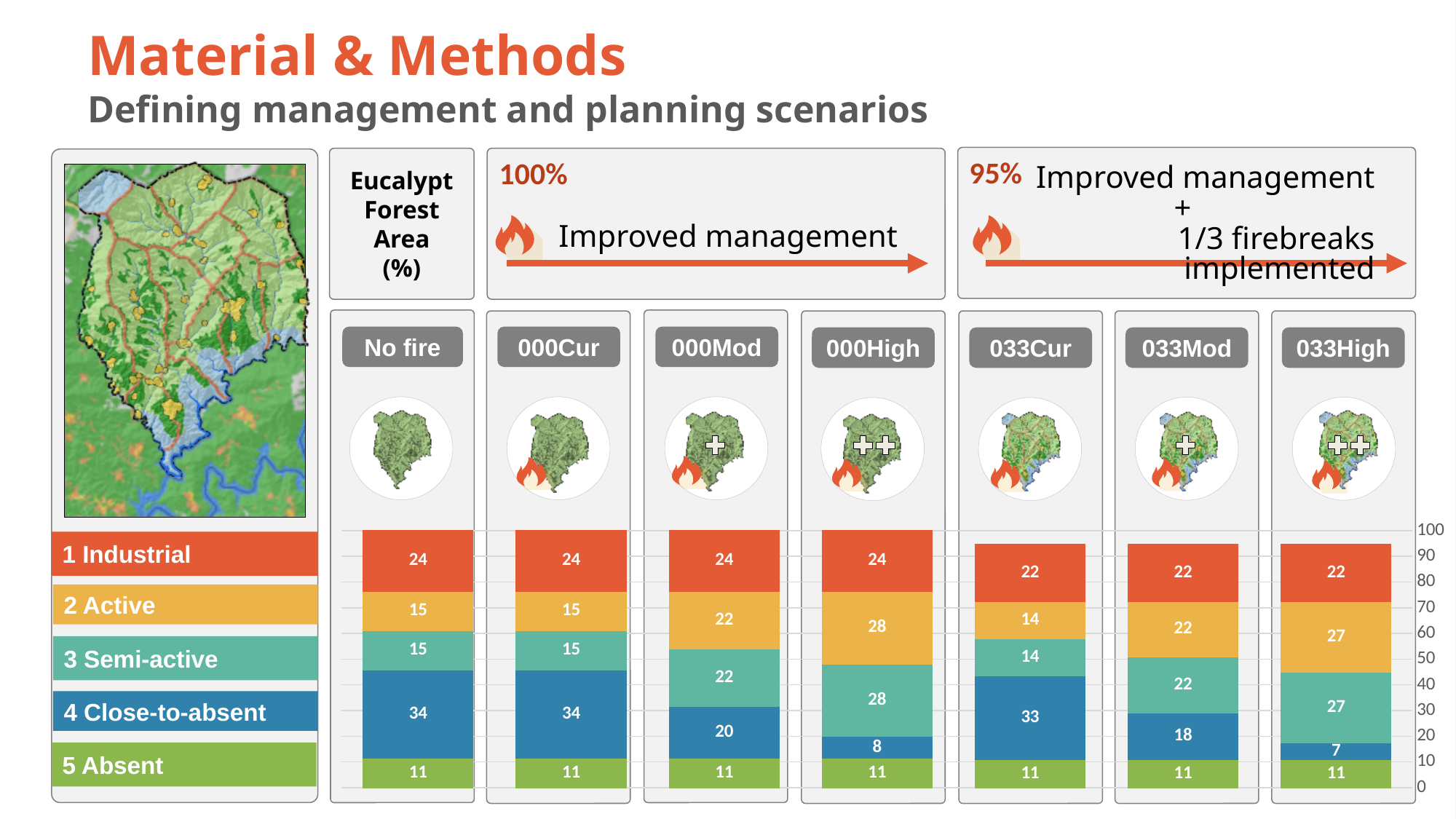
Which legend category is shown in green at the bottom of each bar? 5 Absent What is the difference between the 4 Close-to-absent values for No fire and 000Mod? 14 What is the value for 2 Active in the 033High scenario? 27 Which scenario has the lowest value for 4 Close-to-absent? 033High What kind of chart is shown on the slide? stacked bar chart Which scenario has the highest value for 3 Semi-active? 000High How many management categories (series) does the legend list? 5 What is the value for 1 Industrial in the 033Cur scenario? 22 How many scenario bars are plotted in the chart? 7 What is the total of the stacked bar for the 033Mod scenario? 95 What is the value for 4 Close-to-absent in the 000High scenario? 8 Which is larger: the 2 Active value for 000Mod or for 033Cur? 000Mod